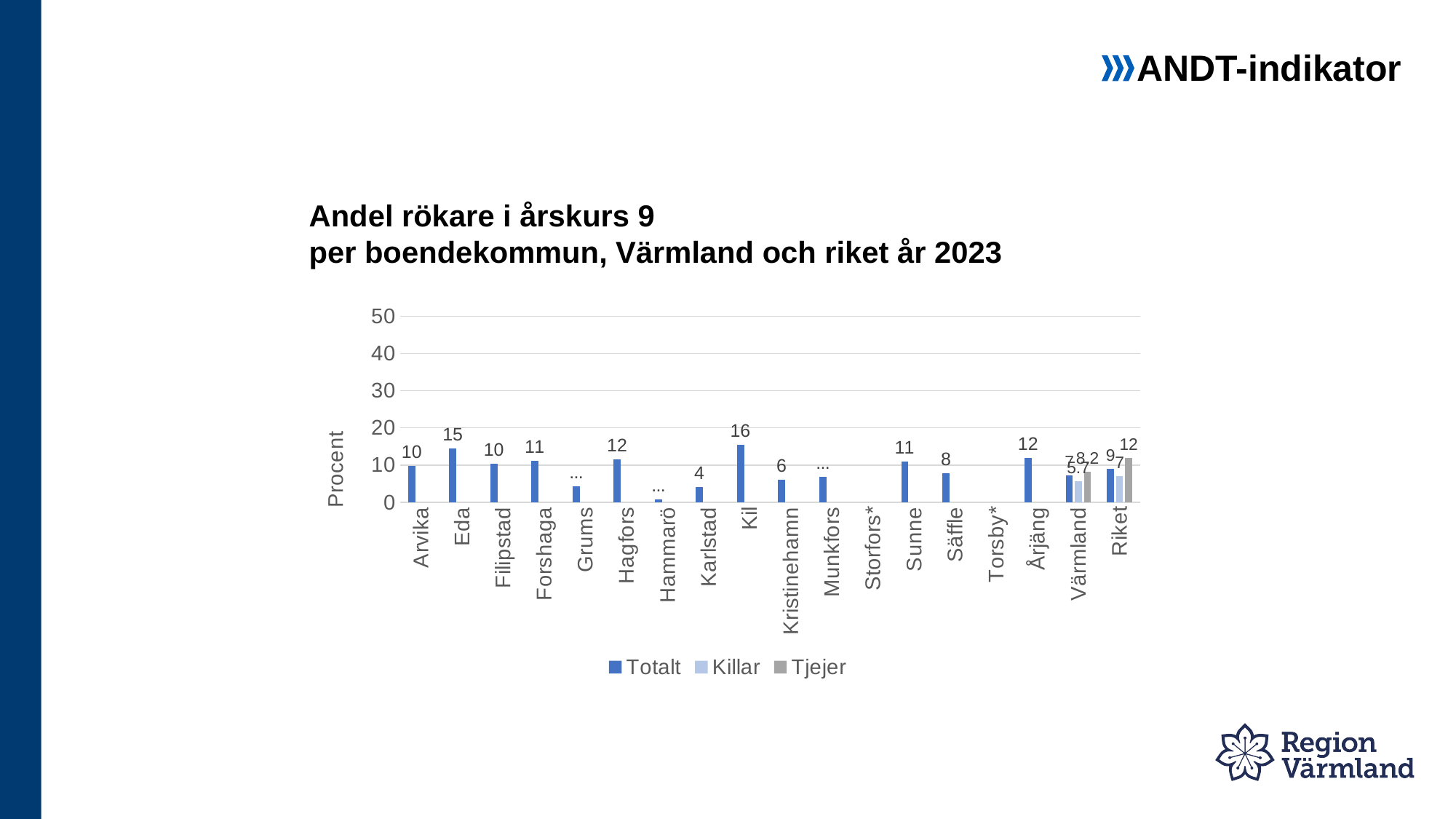
What is the Totalt value for Eda? 15 How many series does the legend list? 3 What kind of chart is shown on the slide? bar chart What is the Totalt value for Kil? 16 What is the Tjejer value for Riket? 12 What is the Killar value for Värmland? 5.7 Which has a higher Totalt value, Hagfors or Säffle? Hagfors Is the Totalt value for Karlstad greater or less than 10? less What is the label on the vertical axis? Procent Which municipality has the highest Totalt value? Kil What is the difference between the Totalt values for Eda and Arvika? 5 What is the difference between the Tjejer and Killar values for Riket? 5